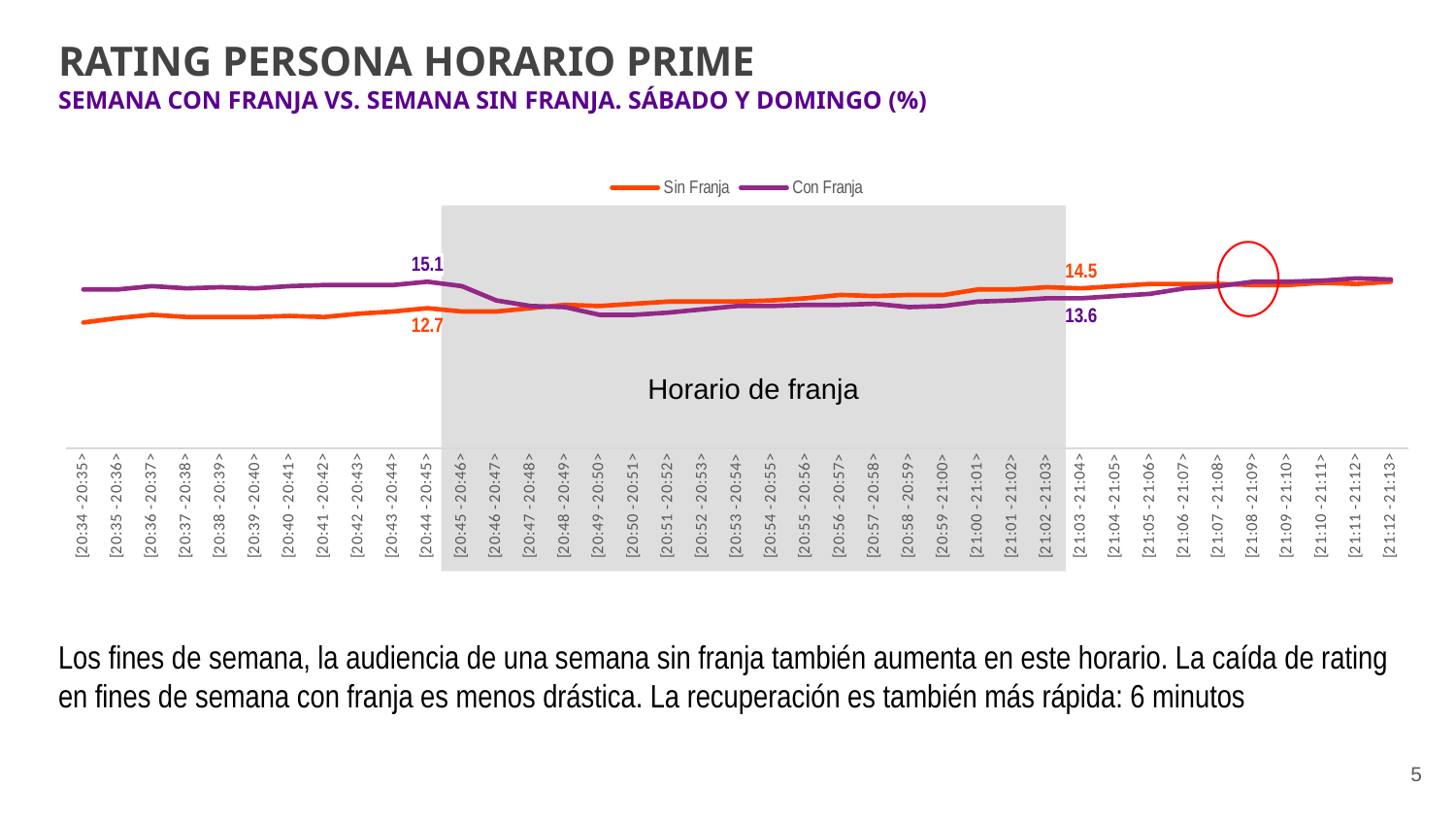
What is the value of Con Franja at [20:44 - 20:45>? 15.1 What is the difference between Con Franja and Sin Franja at [20:44 - 20:45>? 2.4 At [21:02 - 21:03>, which series has the higher value, Sin Franja or Con Franja? Sin Franja What label is written inside the shaded region of the chart? Horario de franja What is the value of Sin Franja at [20:44 - 20:45>? 12.7 What kind of chart is shown on the slide? line chart What is the value of Con Franja at [21:02 - 21:03>? 13.6 How many series does the legend list? 2 At [20:44 - 20:45>, which series has the higher value, Sin Franja or Con Franja? Con Franja Does the Sin Franja line rise or fall from [20:44 - 20:45> to [21:02 - 21:03>? rise